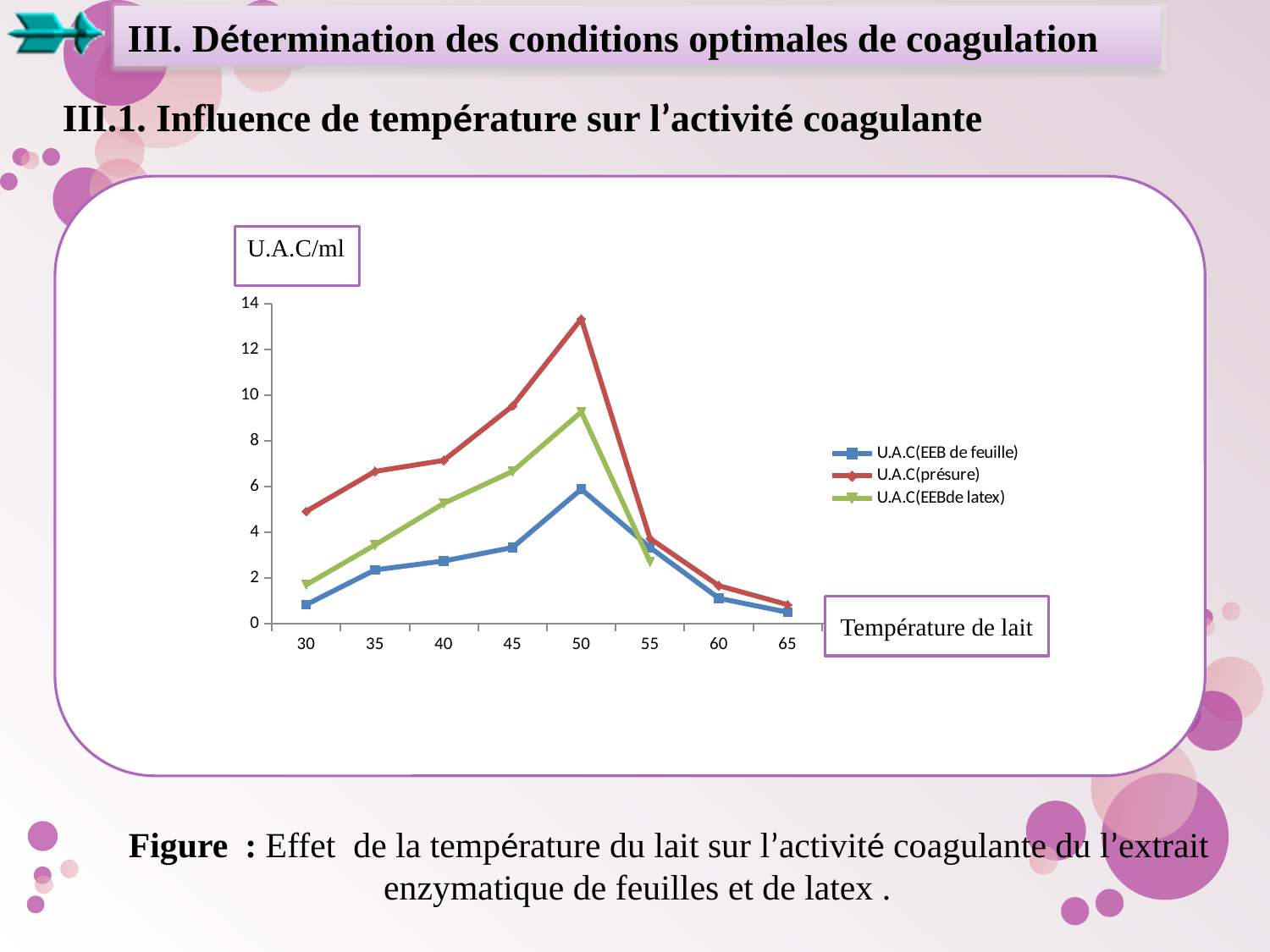
Is the U.A.C(EEBde latex) value at 50 greater or less than 8? greater What kind of chart is shown on the slide? line chart Is the U.A.C(EEB de feuille) value at 30 greater or less than 2? less Is the U.A.C(présure) value at 50 greater or less than 12? greater At 40, which series has the larger value: U.A.C(présure) or U.A.C(EEBde latex)? U.A.C(présure) At which temperature does the U.A.C(EEB de feuille) series reach its highest value? 50 Do the U.A.C(présure) values rise or fall from 30 to 50? rise At which temperature is the U.A.C(présure) value lowest? 65 How many temperature values are plotted along the x axis? 8 How many series does the legend list? 3 At which temperature does the U.A.C(présure) series reach its highest value? 50 What label is shown for the y axis of the chart? U.A.C/ml